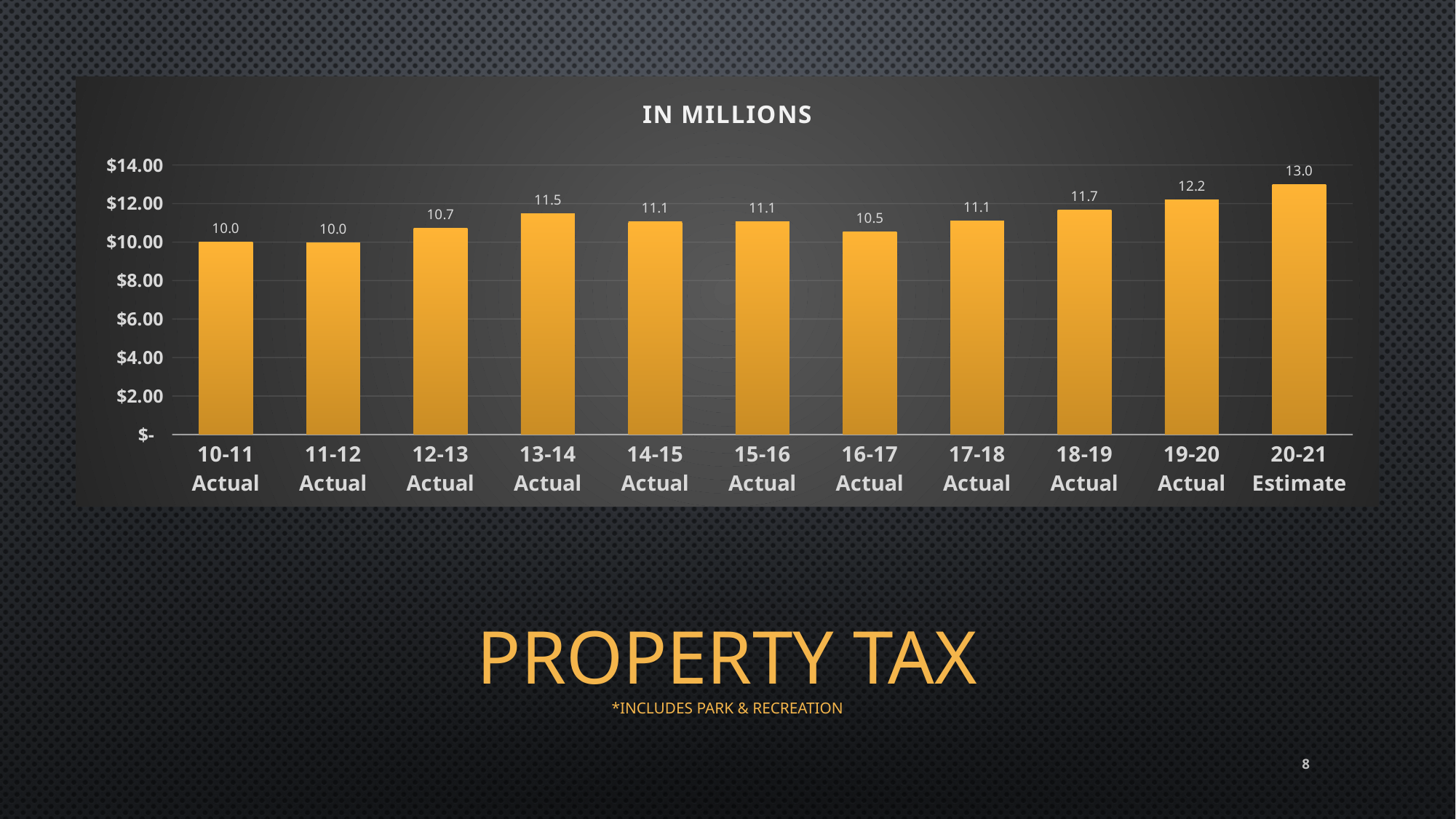
What kind of chart is shown on the slide? bar chart What is the value for 20-21 Estimate? 13.0 What is the value for 13-14 Actual? 11.5 What is the difference between the values for 13-14 Actual and 16-17 Actual? 1.0 Is the value for 19-20 Actual greater or less than $12.00? greater Which category has the highest value? 20-21 Estimate Which is larger, the value for 18-19 Actual or the value for 17-18 Actual? 18-19 Actual Do the values generally rise or fall from 16-17 Actual to 20-21 Estimate? rise What is the value for 16-17 Actual? 10.5 What is the title of the chart? IN MILLIONS What is the difference between the values for 20-21 Estimate and 19-20 Actual? 0.8 How many categories are shown on the x axis? 11